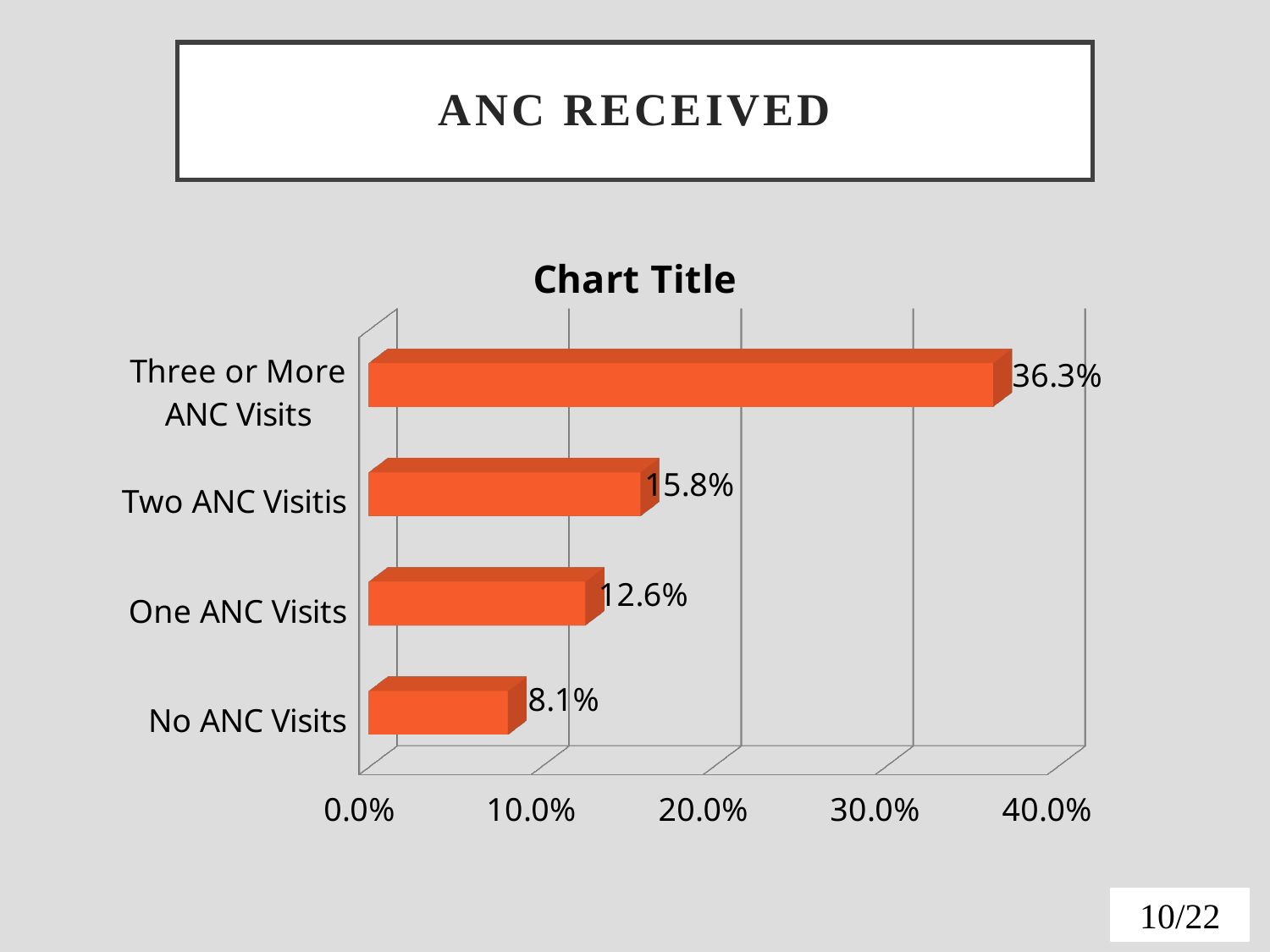
What is the value for One ANC Visits? 12.6% Is the value for Three or More ANC Visits greater or less than 30.0%? greater How many categories are shown in the chart? 4 What is the difference between the values for One ANC Visits and No ANC Visits? 4.5% Which category has the highest value? Three or More ANC Visits Which is larger, the value for Two ANC Visitis or the value for One ANC Visits? Two ANC Visitis What is the value for Two ANC Visitis? 15.8% Which category has the lowest value? No ANC Visits What is the value for Three or More ANC Visits? 36.3% What is the value for No ANC Visits? 8.1% What kind of chart is shown on the slide? bar chart What is the difference between the values for Three or More ANC Visits and Two ANC Visitis? 20.5%